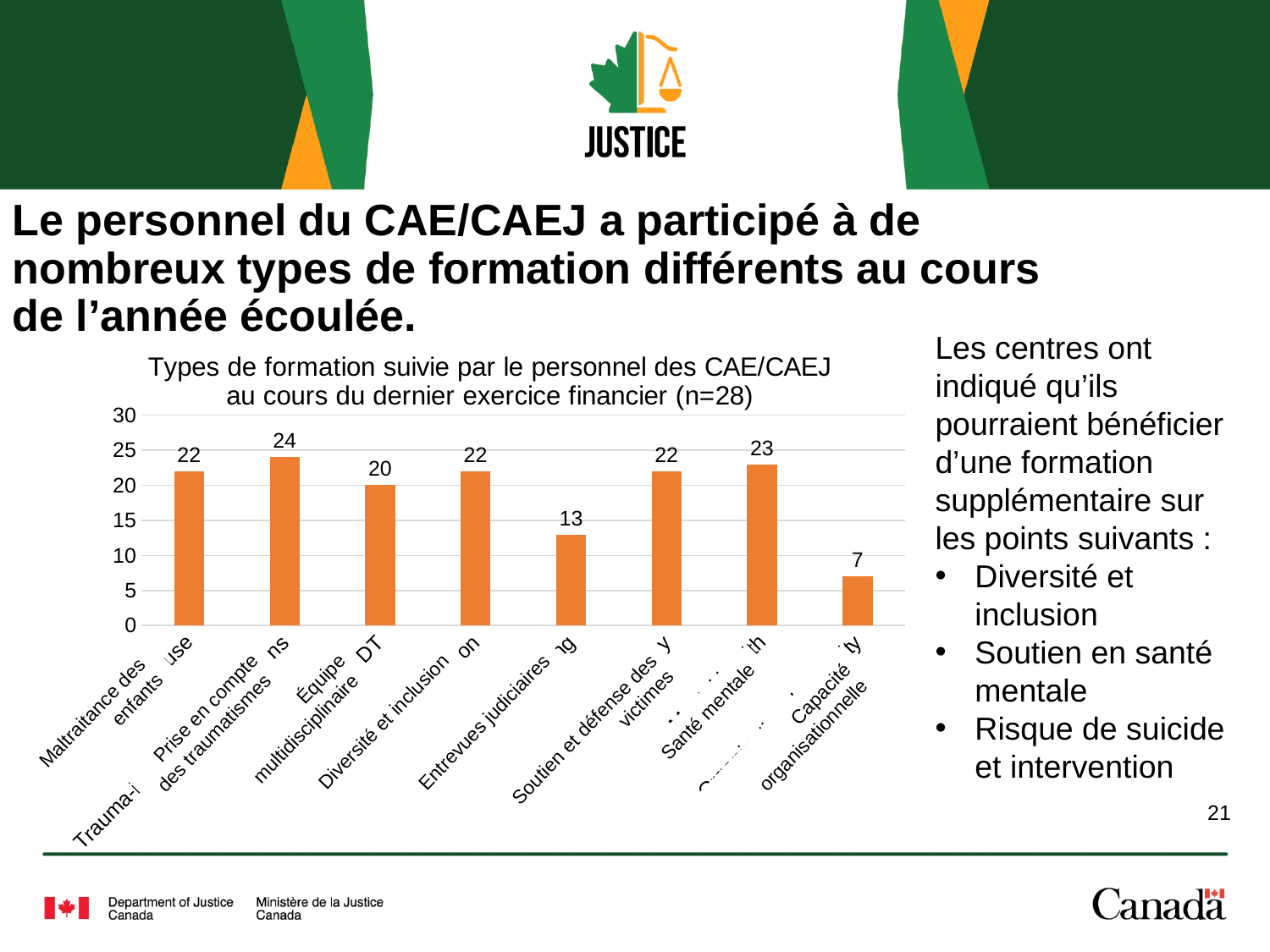
What is the value for Santé mentale? 23 What is the difference between the values for Prise en compte des traumatismes and Capacité organisationnelle? 17 What is the value for Prise en compte des traumatismes? 24 Which category has the lowest value? Capacité organisationnelle How many categories (bars) are shown in the chart? 8 What is the title of the chart? Types de formation suivie par le personnel des CAE/CAEJ au cours du dernier exercice financier (n=28) What is the value for Équipe multidisciplinaire? 20 What type of chart is shown on the slide? bar chart Which category has the highest value? Prise en compte des traumatismes Which is larger, the value for Équipe multidisciplinaire or the value for Santé mentale? Santé mentale What is the value for Capacité organisationnelle? 7 What is the value for Entrevues judiciaires? 13